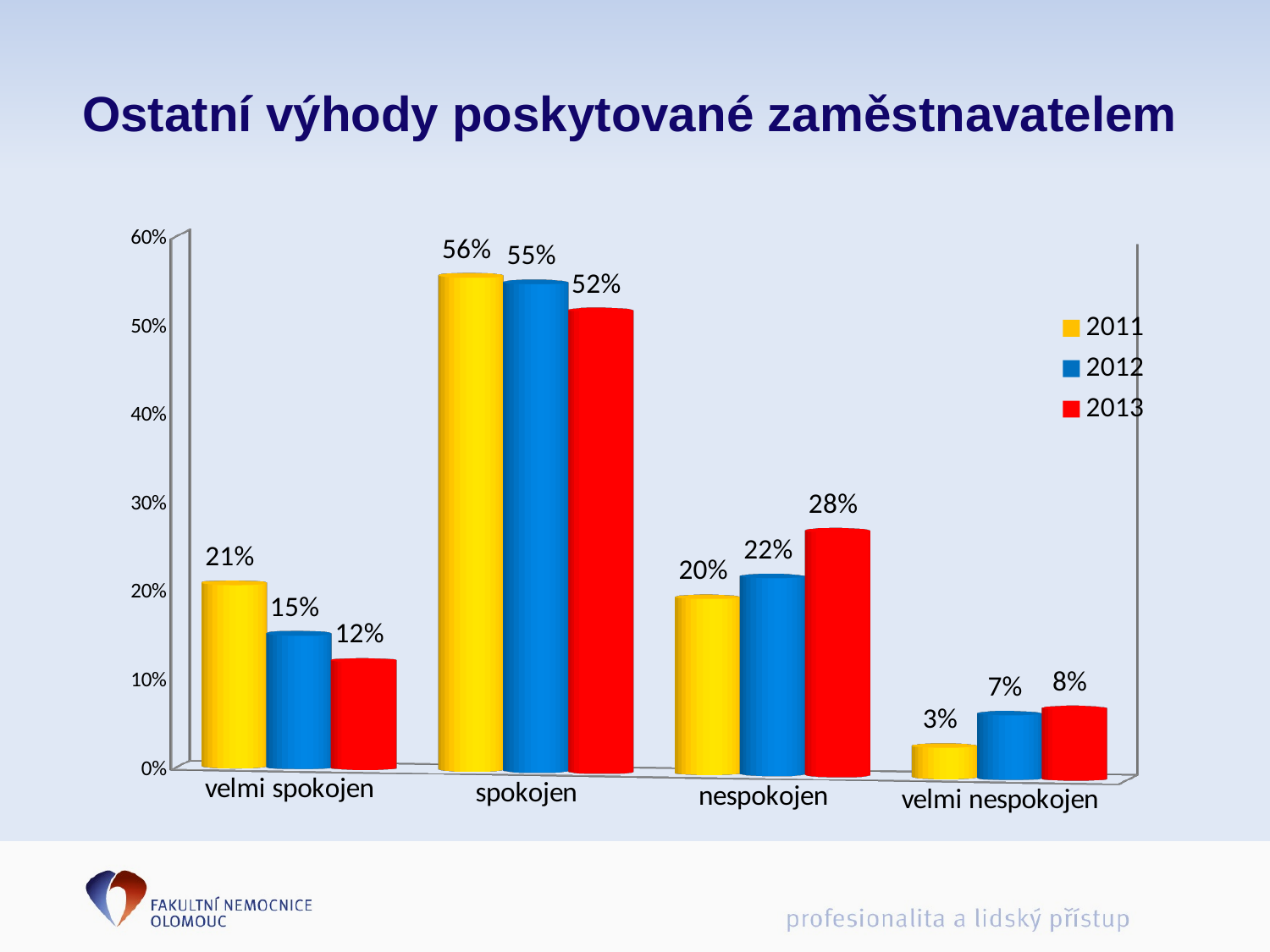
What kind of chart is shown on the slide? bar chart Which is larger for 'velmi spokojen': the 2011 value or the 2013 value? 2011 How many series does the legend list? 3 What is the value for 'velmi nespokojen' in 2011? 3% What is the value for 'spokojen' in 2013? 52% What is the value for 'nespokojen' in 2012? 22% How many categories are shown on the x axis? 4 What is the title of the slide? Ostatní výhody poskytované zaměstnavatelem Which category has the highest value for 2013? spokojen What is the difference between the 2013 and 2011 values for 'nespokojen'? 8% Which category has the lowest value for 2011? velmi nespokojen What is the value for 'velmi spokojen' in 2011? 21%